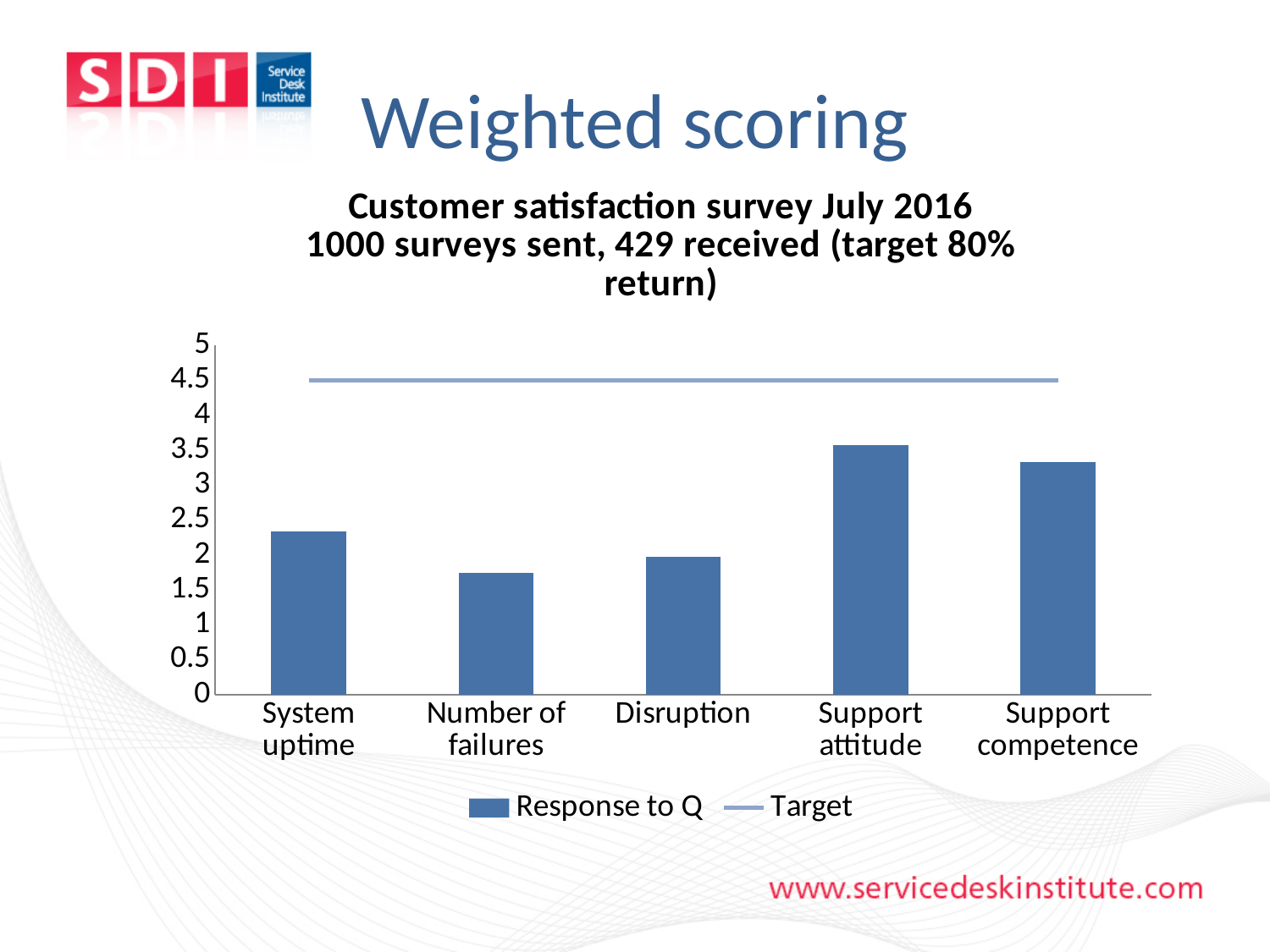
Which has a larger Response to Q value, System uptime or Disruption? System uptime Is the Target line greater or less than 4? greater Is the Response to Q value for System uptime greater or less than 2? greater Is the Response to Q value for Support attitude greater or less than 3? greater Which category has the highest Response to Q value? Support attitude How many categories are shown on the x axis of the chart? 5 What kind of chart is shown on the slide? bar chart How many series does the chart's legend list? 2 What is the title of the chart? Customer satisfaction survey July 2016 1000 surveys sent, 429 received (target 80% return) Which category has the lowest Response to Q value? Number of failures Which has a larger Response to Q value, Support attitude or Support competence? Support attitude